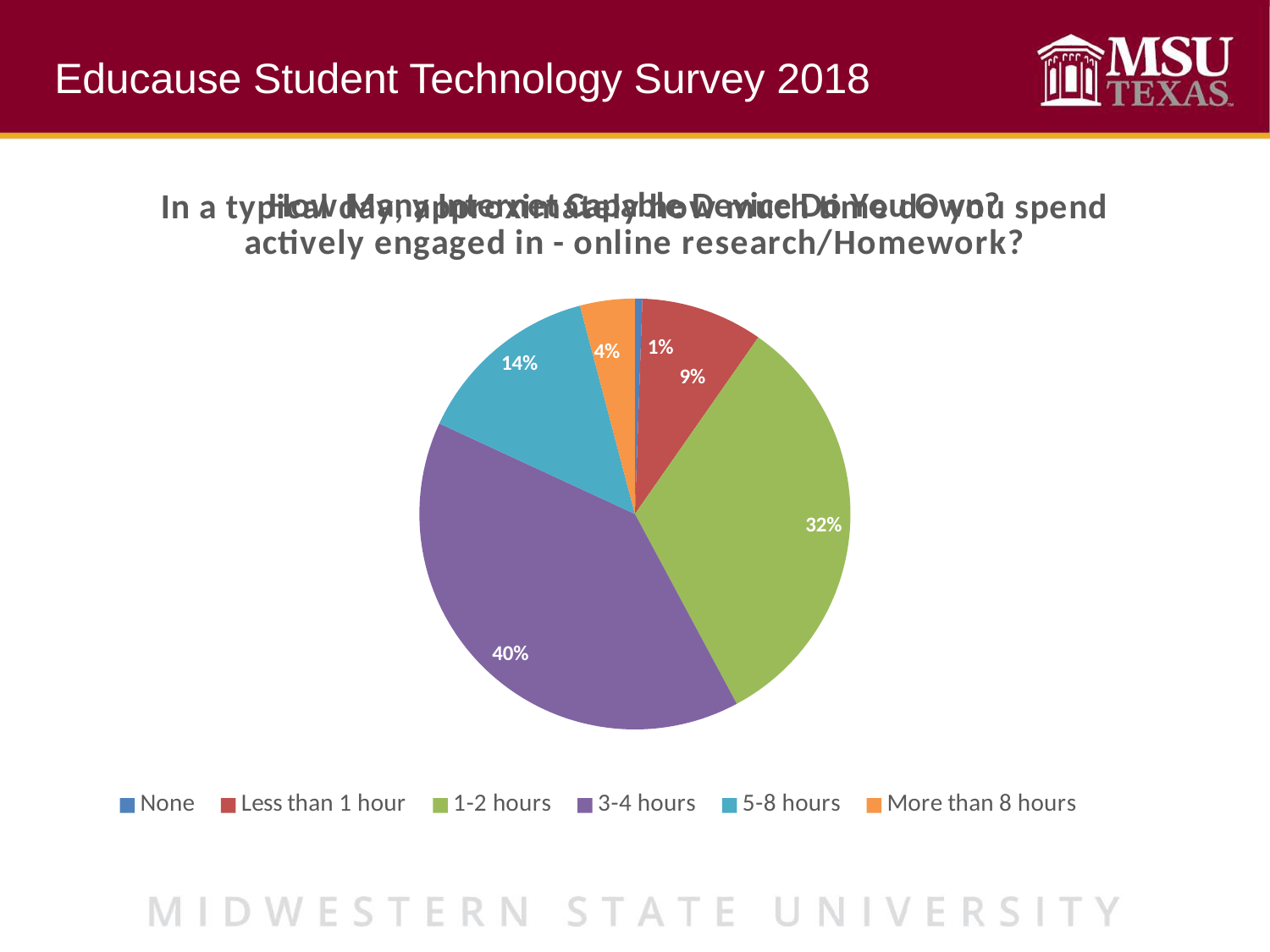
What percentage of respondents chose None? 1% Which category has the smallest share of the pie? None What percentage of respondents chose 3-4 hours? 40% Which is larger, the share for 5-8 hours or the share for Less than 1 hour? 5-8 hours What kind of chart is shown on the slide? pie chart What percentage of respondents chose Less than 1 hour? 9% Which category has the largest share of the pie? 3-4 hours How many categories does the legend list? 6 What percentage of respondents chose More than 8 hours? 4% What percentage of respondents chose 5-8 hours? 14% What percentage of respondents chose 1-2 hours? 32% What is the difference in percentage points between 3-4 hours and 1-2 hours? 8